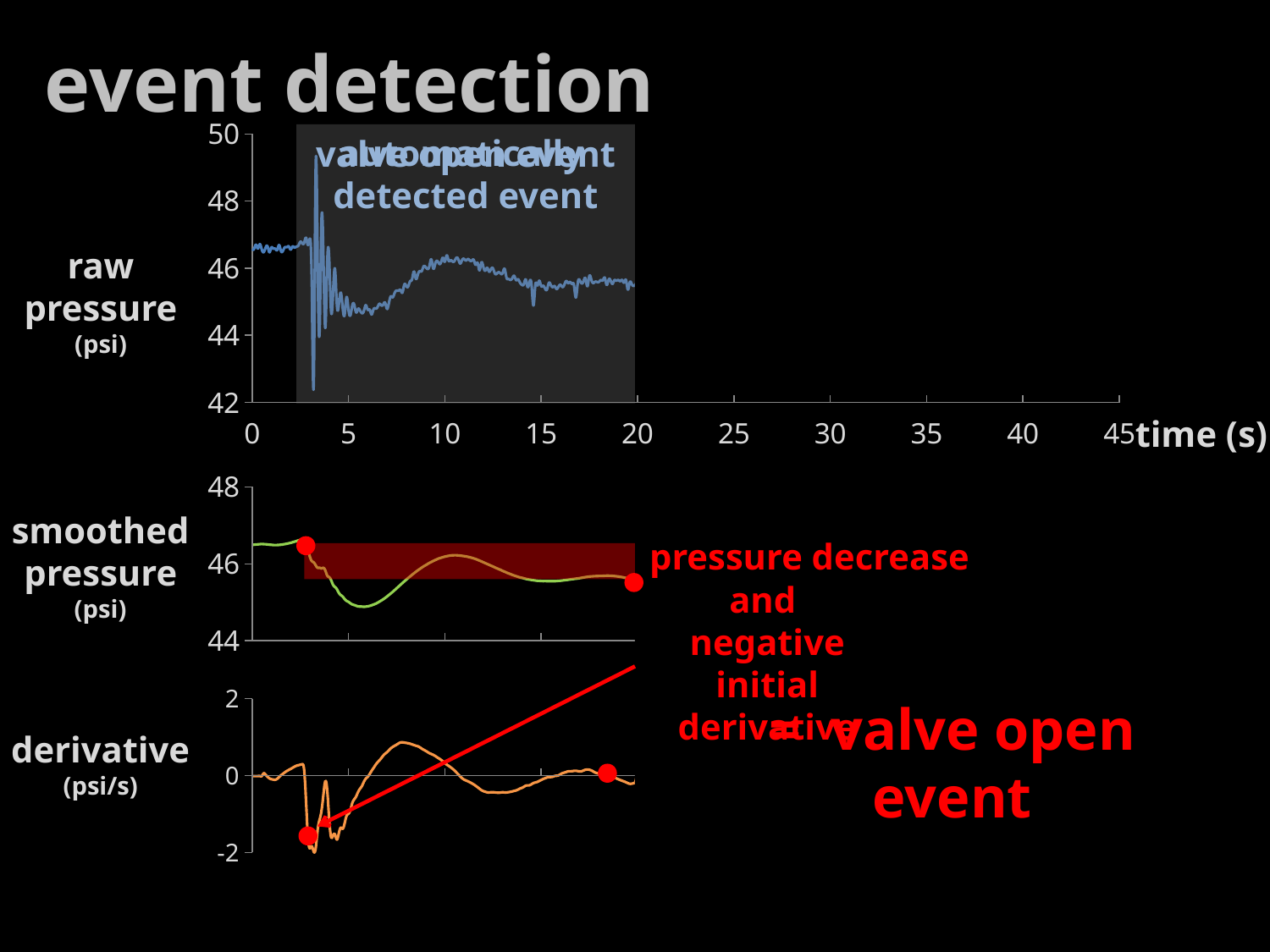
What is the unit shown on the x axis of the raw pressure chart? time (s) In the derivative chart, is the value at the first red marker greater or less than 0? less In the smoothed pressure chart, is the pressure at the first red marker greater or less than 46? greater In the raw pressure chart, is the lowest value of the pressure spike near 3 s greater or less than 44? less In the smoothed pressure chart, does the pressure rise or fall between the first red marker and the second red marker? fall What is the unit of the derivative chart's y axis? psi/s How many charts are shown on the slide? 3 What kind of chart is the raw pressure chart at the top of the slide? line chart In the raw pressure chart, what is the highest value shown on the y axis? 50